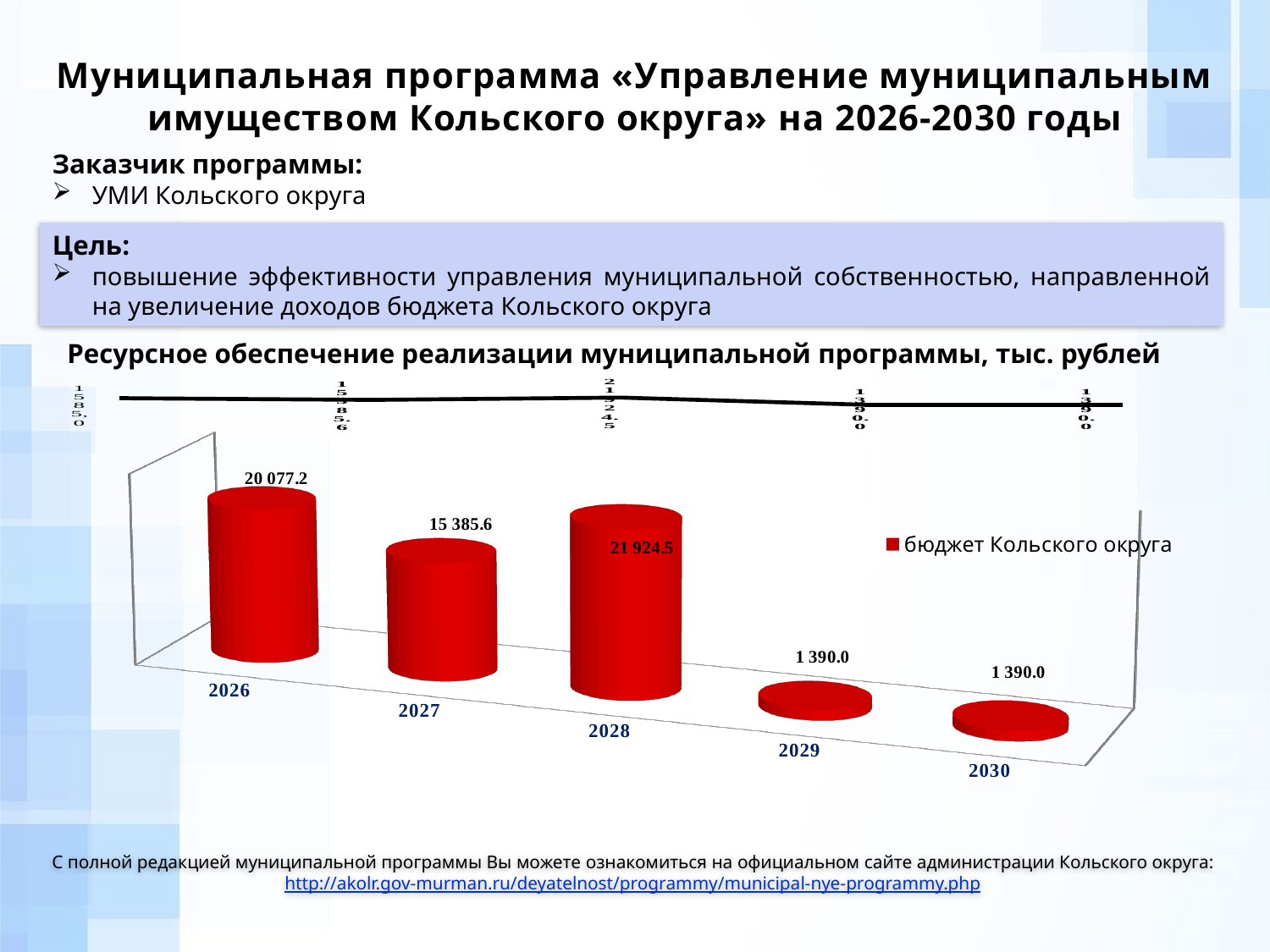
Which year has the highest value in the chart? 2028 What kind of chart is shown on the slide? bar chart How many years are shown on the x axis of the chart? 5 What is the value for 2027 in the chart? 15 385.6 What is the value for 2028 in the chart? 21 924.5 What is the value for 2029 in the chart? 1 390.0 Which year has the larger value, 2026 or 2027? 2026 What is the difference between the values for 2026 and 2027? 4 691.6 What is the value for 2026 in the chart? 20 077.2 What is the difference between the values for 2028 and 2026? 1 847.3 What is the series name shown in the chart legend? бюджет Кольского округа Which years have the lowest value in the chart? 2029 and 2030